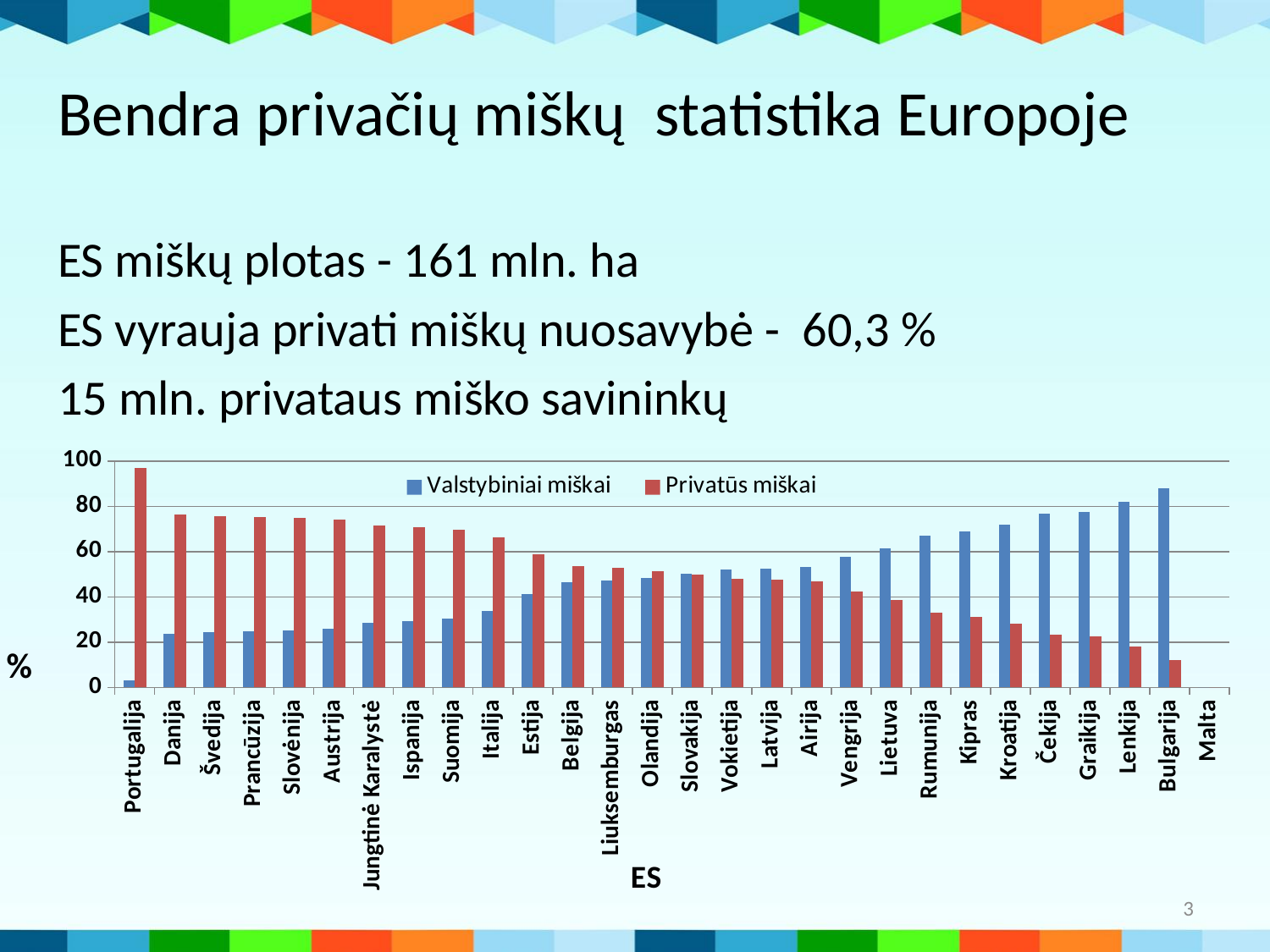
How many series does the chart legend list? 2 Which country has the highest value for Privatūs miškai? Portugalija What is the title of the x axis of the chart? ES Which country has the highest value for Valstybiniai miškai? Bulgarija Is the Privatūs miškai value for Portugalija greater or less than 80? greater Do the Privatūs miškai values generally rise or fall moving from left to right along the x axis? fall What kind of chart is shown on the slide? bar chart How many countries are listed along the x axis of the chart? 28 Is the Privatūs miškai value for Bulgarija greater or less than 20? less For Danija, which series has the larger value, Valstybiniai miškai or Privatūs miškai? Privatūs miškai